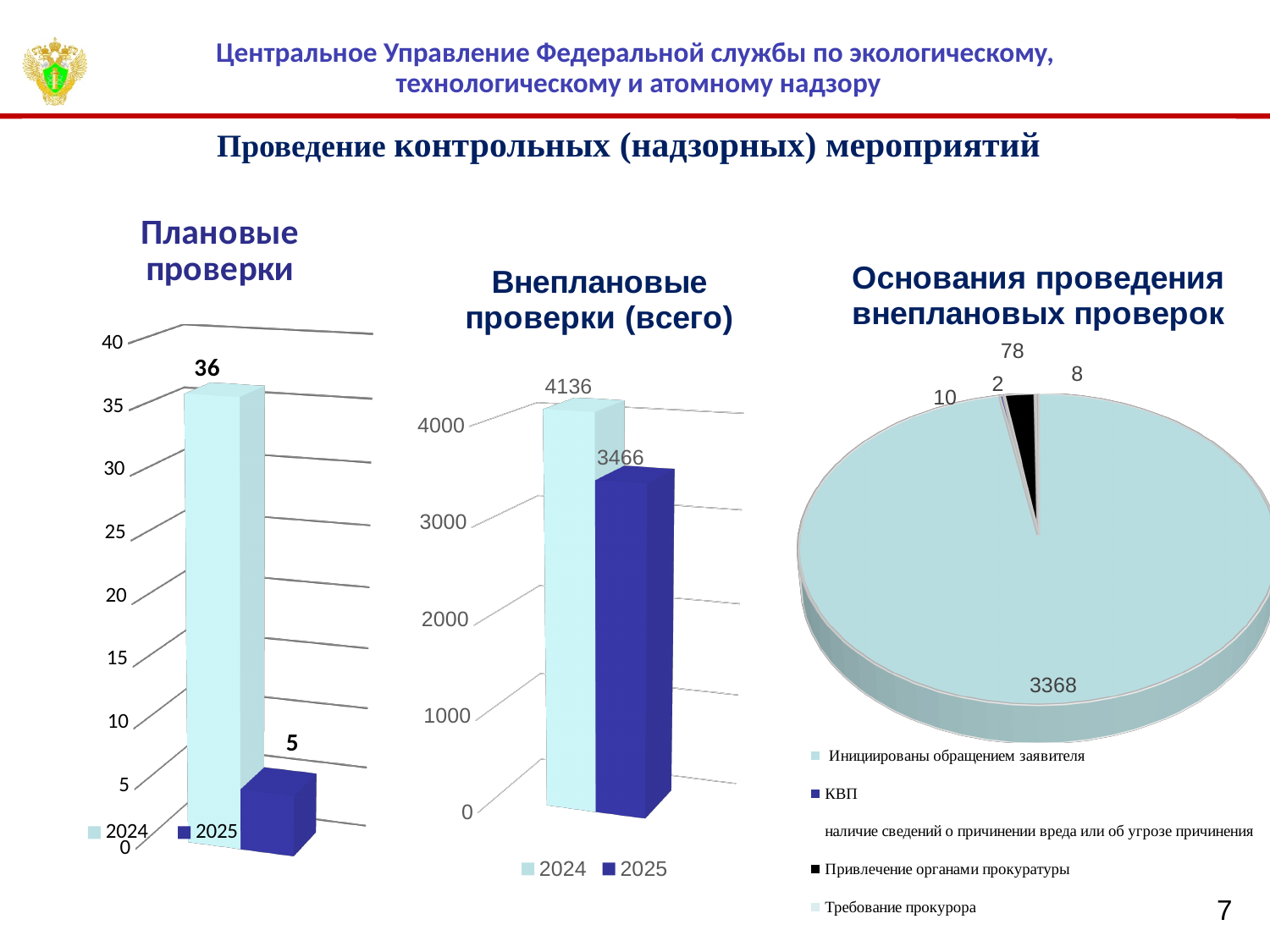
What kind of chart is 'Основания проведения внеплановых проверок'? pie chart In the 'Плановые проверки' chart, which year has the higher value, 2024 or 2025? 2024 In the 'Плановые проверки' chart, what is the difference between the 2024 and 2025 values? 31 In the 'Внеплановые проверки (всего)' chart, what is the value for 2024? 4136 How many entries does the legend of the 'Основания проведения внеплановых проверок' pie chart list? 5 What kind of chart is 'Внеплановые проверки (всего)'? bar chart In the 'Внеплановые проверки (всего)' chart, what is the value for 2025? 3466 In the 'Внеплановые проверки (всего)' chart, by how much did the value fall from 2024 to 2025? 670 In the 'Плановые проверки' chart, what is the value for 2024? 36 In the 'Внеплановые проверки (всего)' chart, is the value for 2025 greater or less than 3000? greater In the 'Плановые проверки' chart, what is the value for 2025? 5 In the 'Основания проведения внеплановых проверок' pie chart, what is the value of the largest slice? 3368